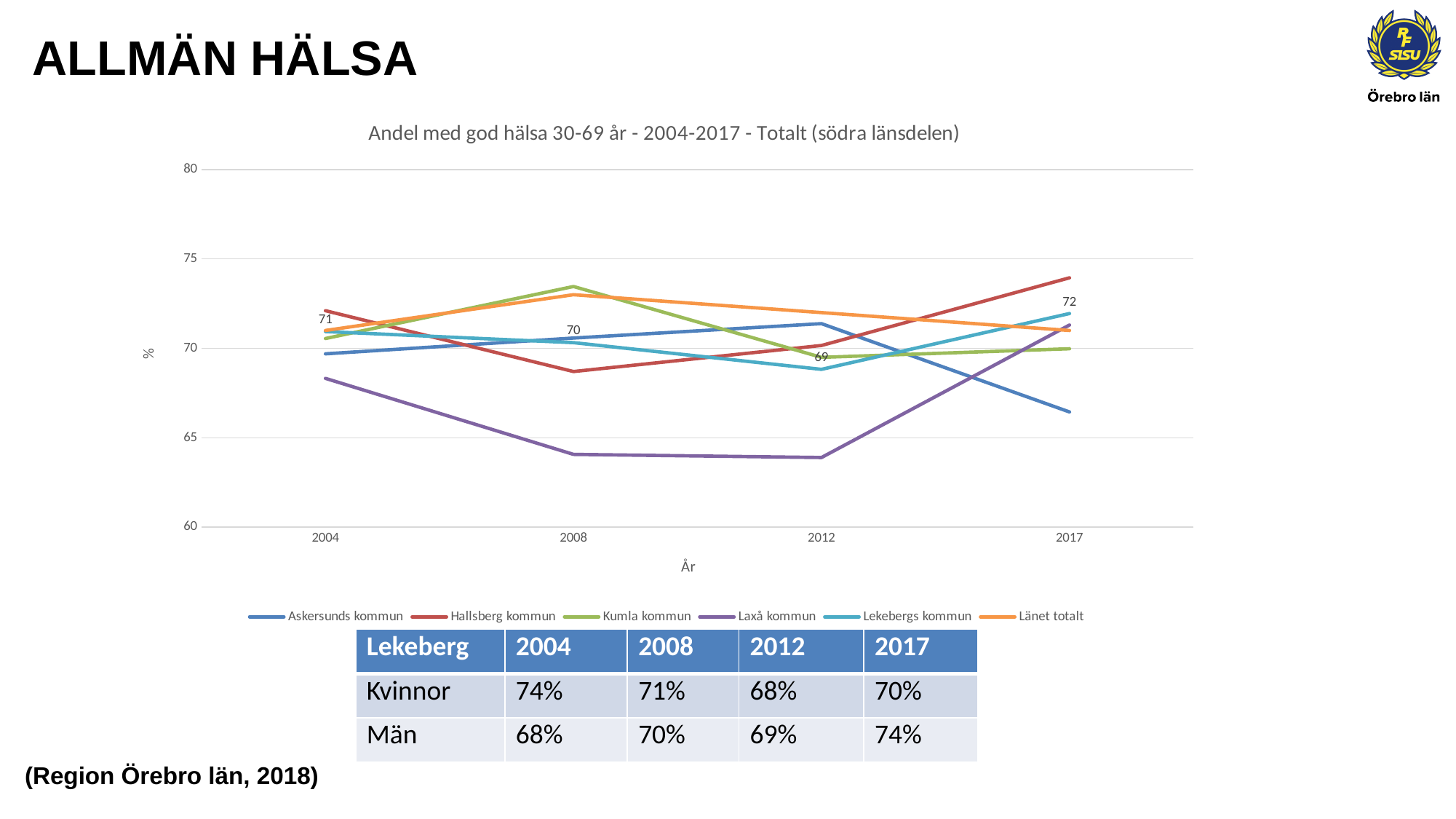
Which municipality has the lowest value in 2012? Laxå kommun What is the value for Lekebergs kommun in 2012? 69 What kind of chart is shown on the slide? line chart What is the value for Lekebergs kommun in 2017? 72 Is the value for Laxå kommun in 2008 greater or less than 65? less How many series does the chart legend list? 6 What is the title of the chart? Andel med god hälsa 30-69 år - 2004-2017 - Totalt (södra länsdelen) Which is larger in 2004, the value for Askersunds kommun or the value for Laxå kommun? Askersunds kommun How many years are plotted along the x axis of the chart? 4 Which series has the highest value in 2017? Hallsberg kommun What is the value for Lekebergs kommun in 2004? 71 By how much did the value for Lekebergs kommun increase from 2012 to 2017? 3